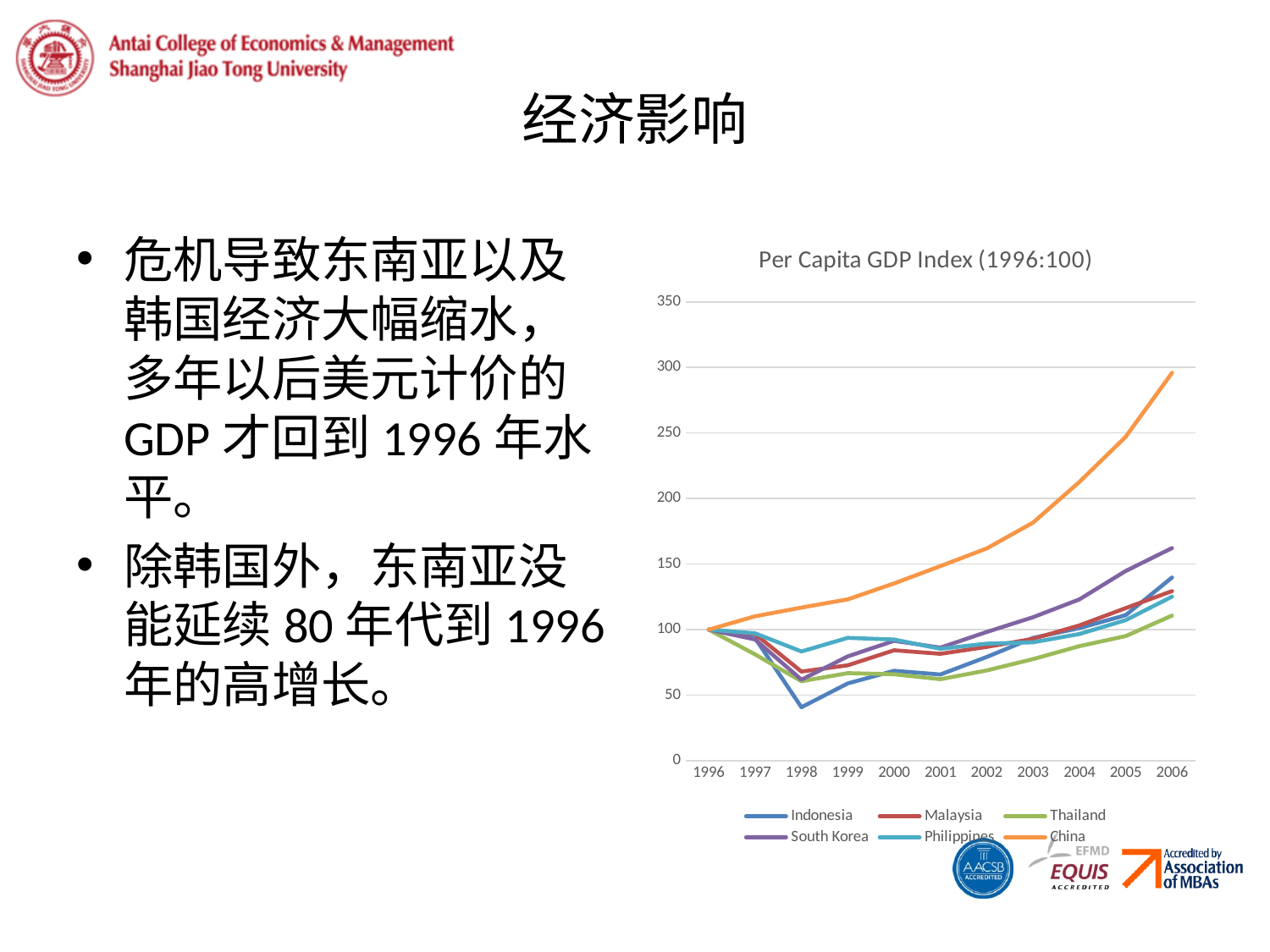
Does the line for China rise or fall from 1996 to 2006? rises Is the value for Indonesia in 1998 greater or less than 50? less Which country has the highest index value in 2006? China Is the value for South Korea in 2006 greater or less than 150? greater How many series does the chart's legend list? 6 Is the value for China in 2006 greater or less than 250? greater Which country has the lowest index value in 1998? Indonesia What kind of chart is shown on the slide? line chart How many years are plotted along the x axis of the chart? 11 What is the value of the index for all countries in 1996? 100 What is the title of the chart? Per Capita GDP Index (1996:100) In 2006, which is larger: the value for China or the value for Thailand? China